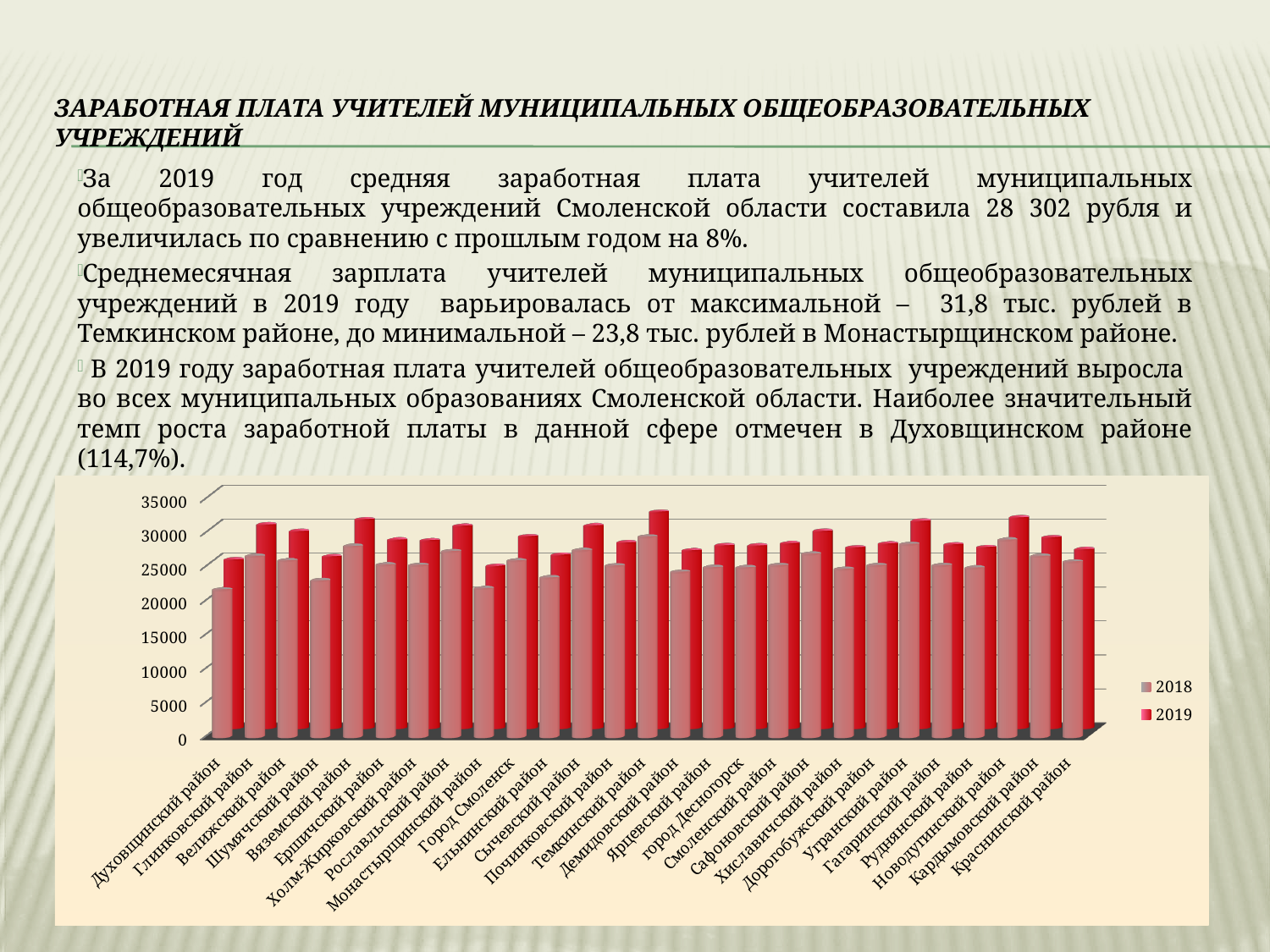
Which colour represents the 2019 series in the chart? red Is the 2019 value for Темкинский район greater or less than 30000? greater Which category has the highest 2019 value in the chart? Темкинский район Is the 2018 value for Духовщинский район greater or less than 25000? less Which years are listed in the chart legend? 2018 and 2019 Which has the larger 2019 value: Темкинский район or Духовщинский район? Темкинский район Is the 2019 value for Вяземский район greater or less than 30000? greater How many series does the legend list? 2 Which category has the lowest 2019 value in the chart? Монастырщинский район What kind of chart is shown on the slide? bar chart Which is larger for Духовщинский район: the 2018 value or the 2019 value? 2019 How many municipal districts (categories) are shown on the x axis of the chart? 27